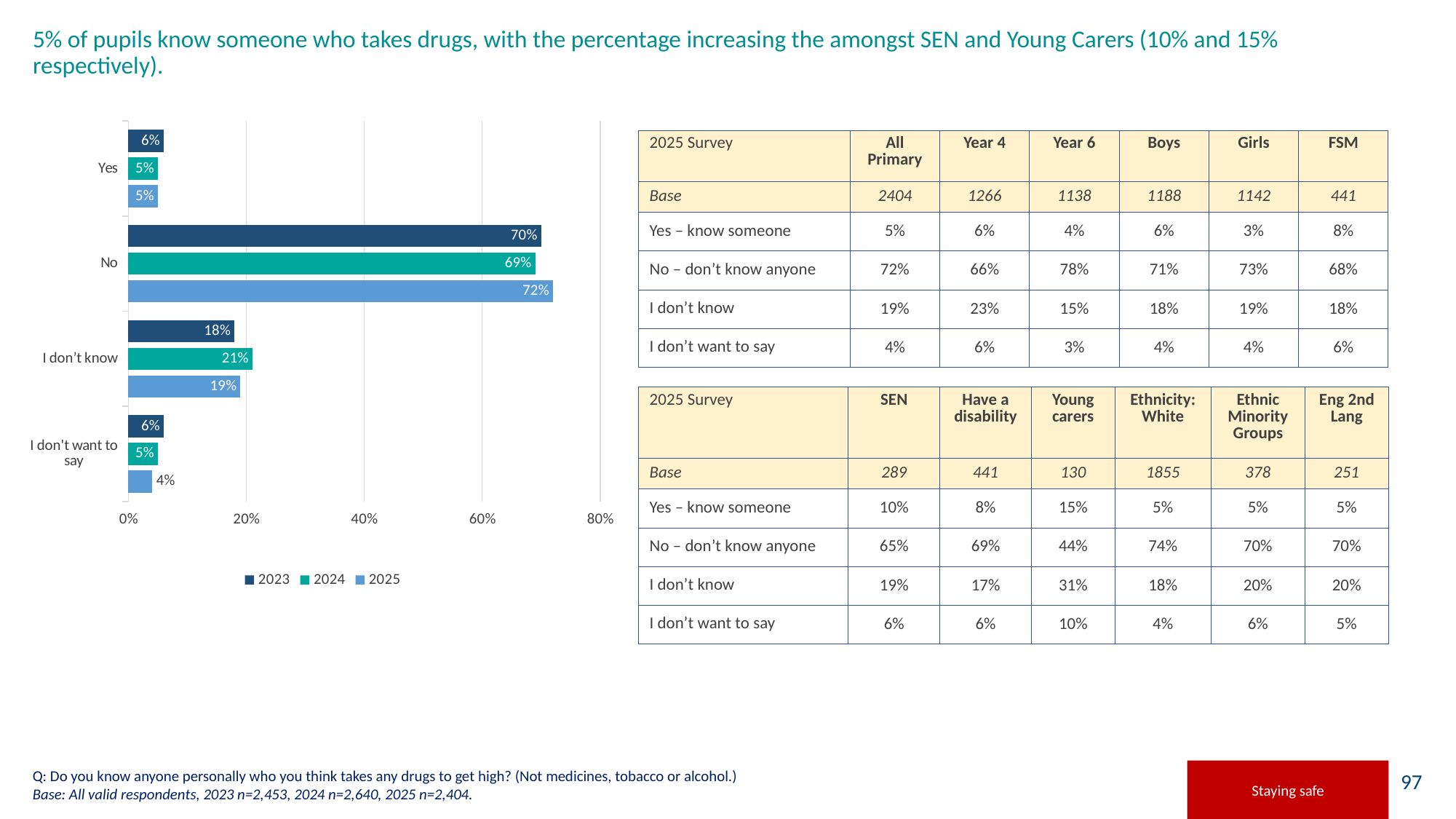
How many response categories are shown on the chart? 4 What is the value for 'Yes' in 2023? 6% Which years are listed in the chart legend? 2023, 2024, 2025 Is the value for 'No' in 2023 greater or less than 60%? greater What is the value for 'No' in 2025? 72% What is the value for 'I don't know' in 2024? 21% What kind of chart is shown on the slide? Bar chart How many series does the chart legend list? 3 Which is larger: 'I don't know' in 2024 or 'I don't know' in 2023? 2024 Which response category has the highest value in 2025? No What is the difference between the 'No' values for 2025 and 2024? 3% What is the value for 'I don't want to say' in 2025? 4%